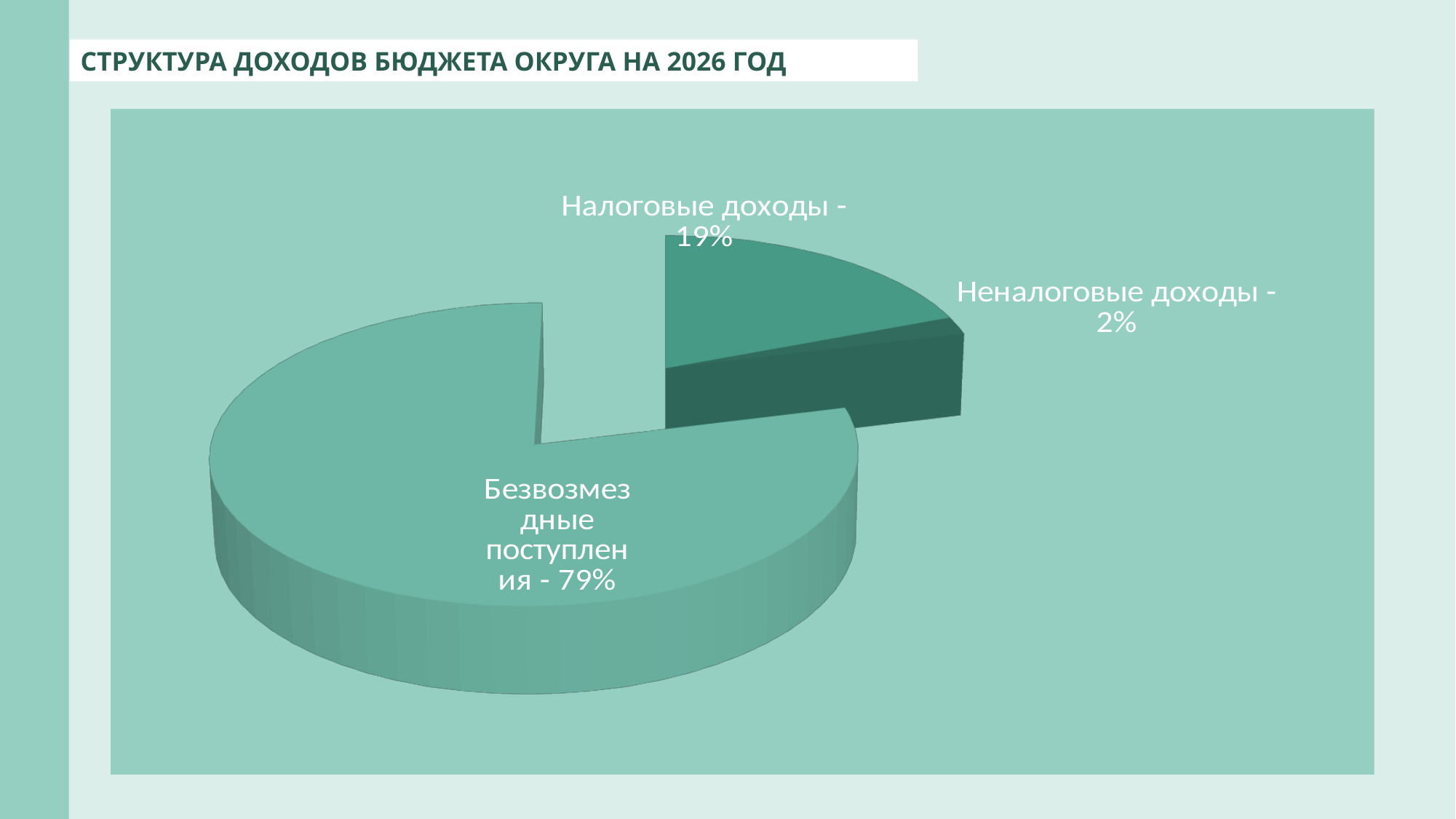
What share of the pie is Налоговые доходы? 19% Which category has the largest share of the pie? Безвозмездные поступления What share of the pie is Безвозмездные поступления? 79% Which is larger: Налоговые доходы or Неналоговые доходы? Налоговые доходы What is the difference in percentage points between Налоговые доходы and Неналоговые доходы? 17 What share of the pie is Неналоговые доходы? 2% What kind of chart is shown on the slide? Pie chart Which category has the smallest share of the pie? Неналоговые доходы What is the difference in percentage points between Безвозмездные поступления and Налоговые доходы? 60 How many slices does the pie chart have? 3 What is the title of the slide? СТРУКТУРА ДОХОДОВ БЮДЖЕТА ОКРУГА НА 2026 ГОД What is the combined share of Налоговые доходы and Неналоговые доходы? 21%